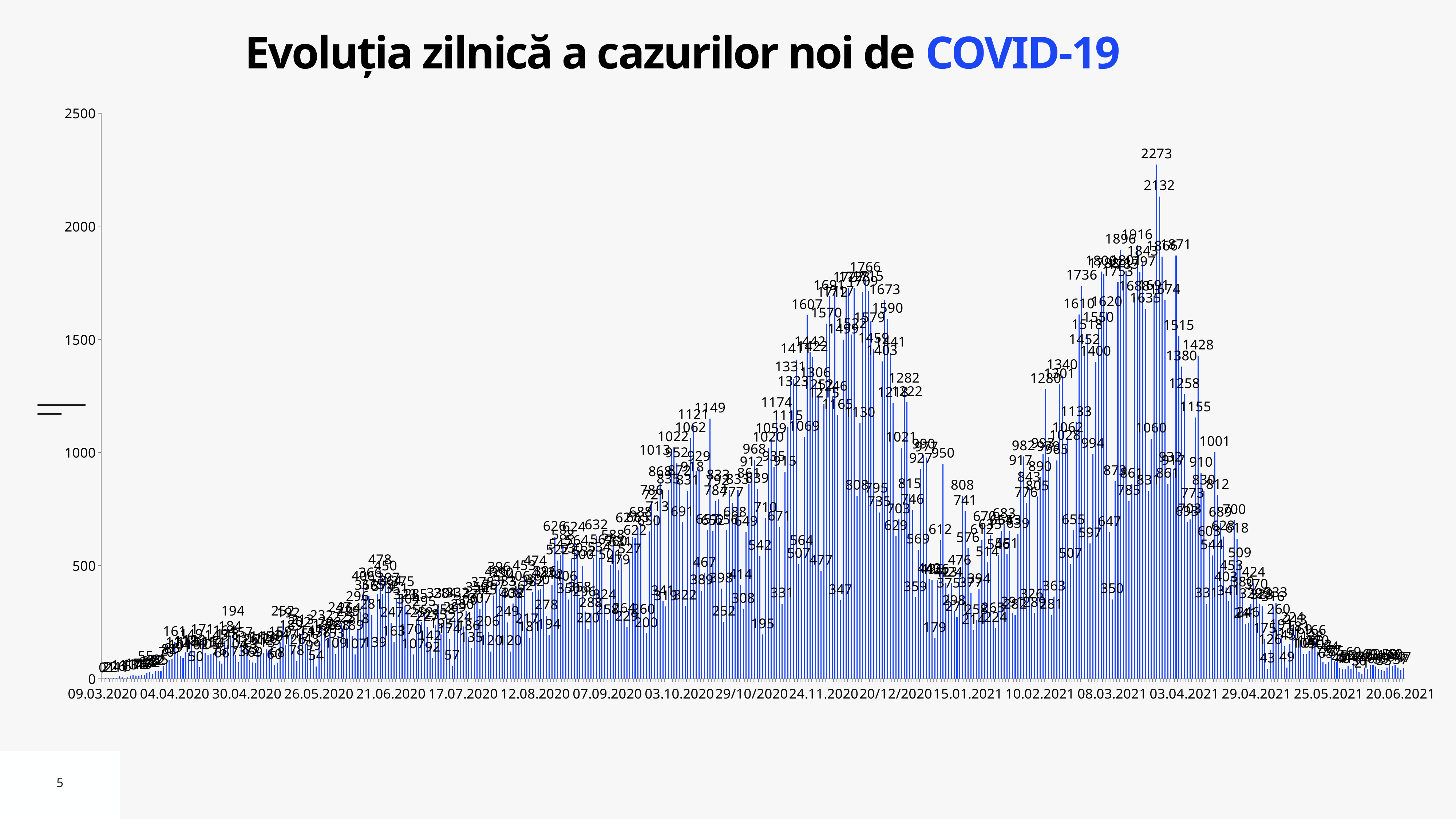
What is the highest daily value labelled on the chart? 2273 Is the highest bar on the chart greater or less than 2000? greater How many date labels are shown along the x axis? 19 Which peak is higher: the one near 03.04.2021 or the one near 20/12/2020? the one near 03.04.2021 What is the title of the chart? Evoluția zilnică a cazurilor noi de COVID-19 What is the highest tick value shown on the vertical axis? 2500 What is the highest value labelled in the wave around 24.11.2020 to 20/12/2020? 1766 What is the second-highest daily value labelled on the chart, next to the 2273 peak? 2132 Is the value for the last date, 20.06.2021, greater or less than 500? less What kind of chart is shown on the slide? bar chart Do the values rise or fall from 03.04.2021 to 20.06.2021? fall What is the highest value labelled in the first wave, around 21.06.2020? 478